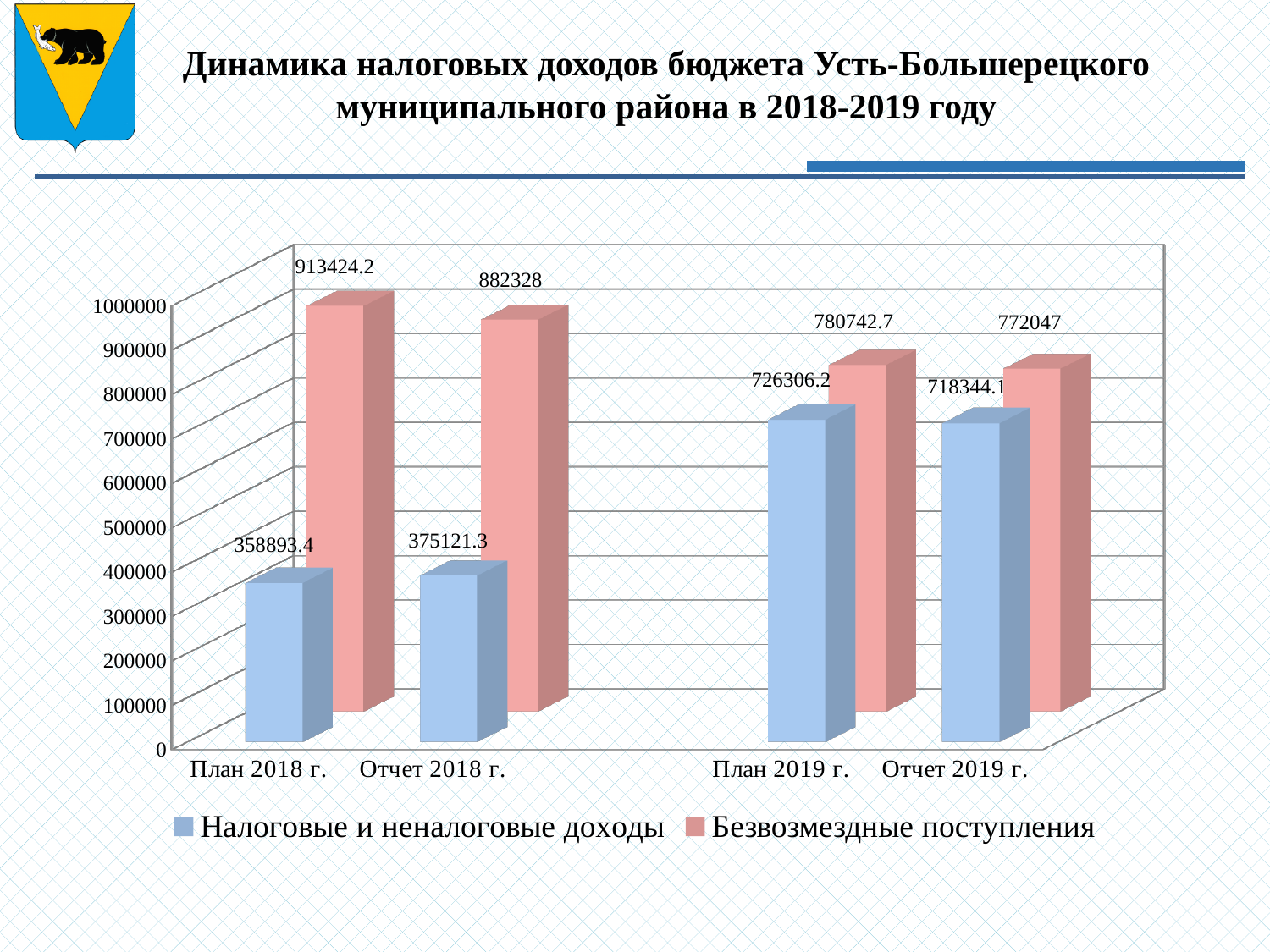
In which category is Безвозмездные поступления highest? План 2018 г. In which category is Налоговые и неналоговые доходы lowest? План 2018 г. What is the difference between Безвозмездные поступления for Отчет 2018 г. and Отчет 2019 г.? 110281 What kind of chart is shown on the slide? Bar chart What is the difference between Безвозмездные поступления and Налоговые и неналоговые доходы for План 2018 г.? 554530.8 What is the value of Налоговые и неналоговые доходы for Отчет 2019 г.? 718344.1 Which is larger: Налоговые и неналоговые доходы for План 2019 г. or for Отчет 2018 г.? План 2019 г. What is the value of Безвозмездные поступления for Отчет 2018 г.? 882328 What is the value of Безвозмездные поступления for План 2019 г.? 780742.7 How many series does the legend list? 2 How many categories are shown on the x axis? 4 What is the value of Налоговые и неналоговые доходы for План 2018 г.? 358893.4